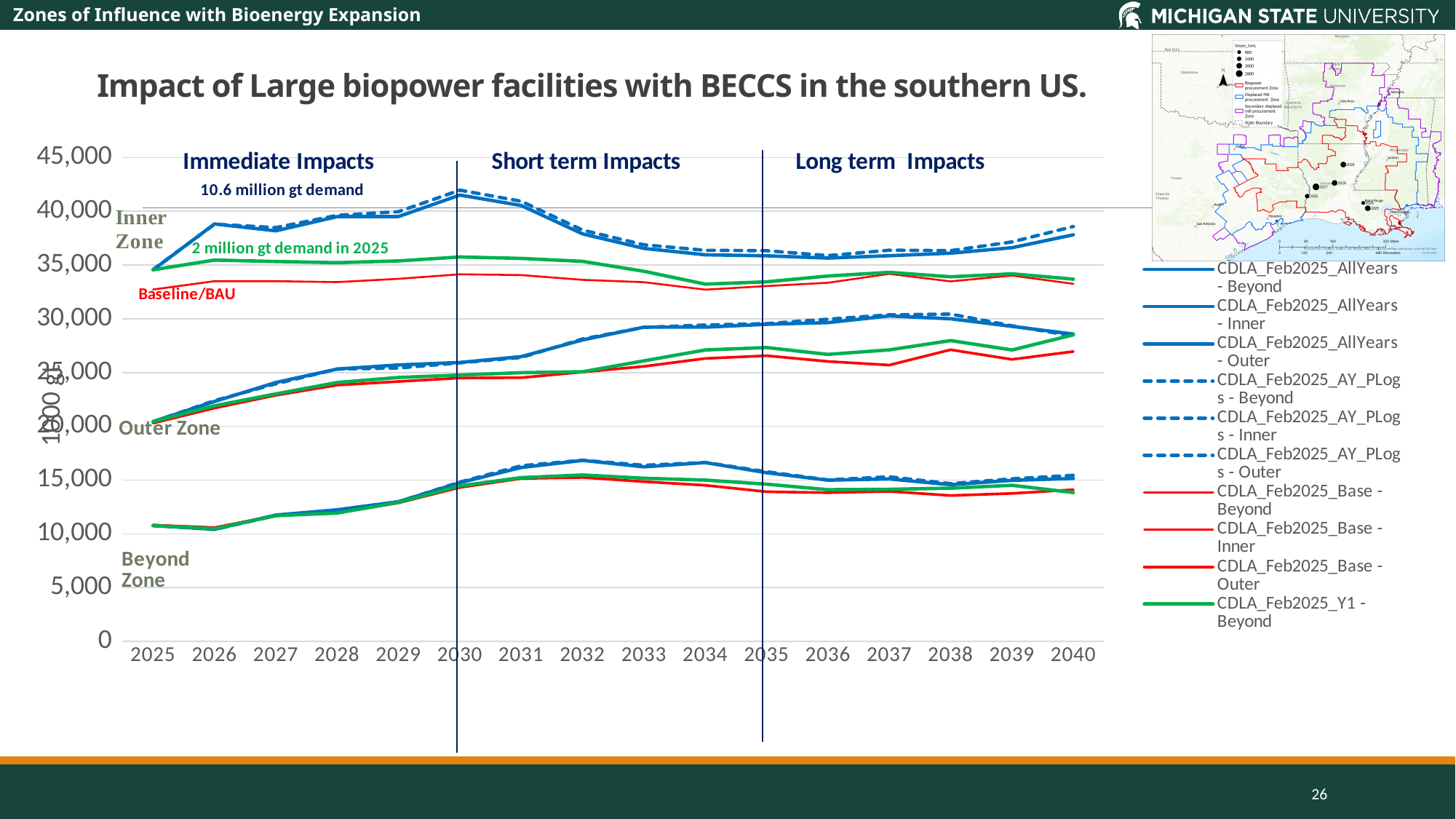
Is the value for CDLA_Feb2025_Base - Inner in 2030 greater or less than 35,000? less Does the CDLA_Feb2025_Base - Beyond series rise or fall from 2025 to 2032? rise Does the CDLA_Feb2025_AllYears - Inner series rise or fall from 2030 to 2036? fall Is the value for CDLA_Feb2025_AllYears - Beyond in 2032 greater or less than 15,000? greater How many years are shown along the x axis of the chart? 16 Is the value for CDLA_Feb2025_AllYears - Inner in 2030 greater or less than 40,000? greater What are the three impact periods labelled across the top of the chart? Immediate Impacts, Short term Impacts, Long term Impacts In 2030, which is larger: CDLA_Feb2025_AllYears - Inner or CDLA_Feb2025_Base - Inner? CDLA_Feb2025_AllYears - Inner What is the title of the chart? Impact of Large biopower facilities with BECCS in the southern US. How many series does the chart legend list? 10 What kind of chart is shown on the slide? line chart